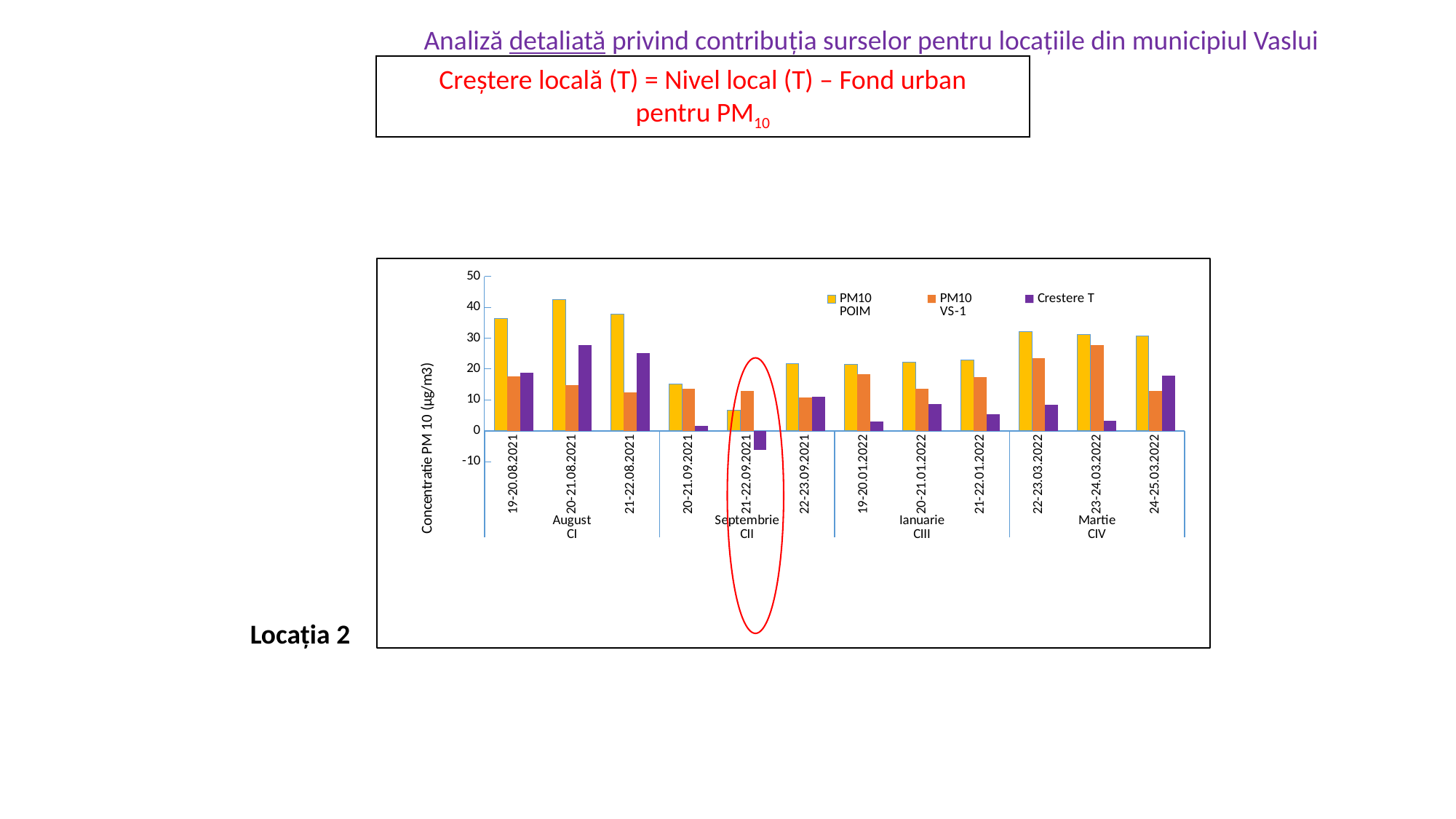
For which date is the PM10 POIM value highest? 20-21.08.2021 For 21-22.09.2021, which is larger: PM10 POIM or PM10 VS-1? PM10 VS-1 How many date categories are plotted along the x axis? 12 Which date category is circled in red on the chart? 21-22.09.2021 Is the PM10 POIM value for 20-21.08.2021 greater or less than 40? greater How many month groups (campaigns) are labelled along the x axis? 4 For which date is the PM10 VS-1 value highest? 23-24.03.2022 For which date is the PM10 POIM value lowest? 21-22.09.2021 Is the Crestere T value for 21-22.09.2021 greater or less than 0? less For which date is the Crestere T value lowest? 21-22.09.2021 What kind of chart is shown on the slide? bar chart How many series does the legend list? 3